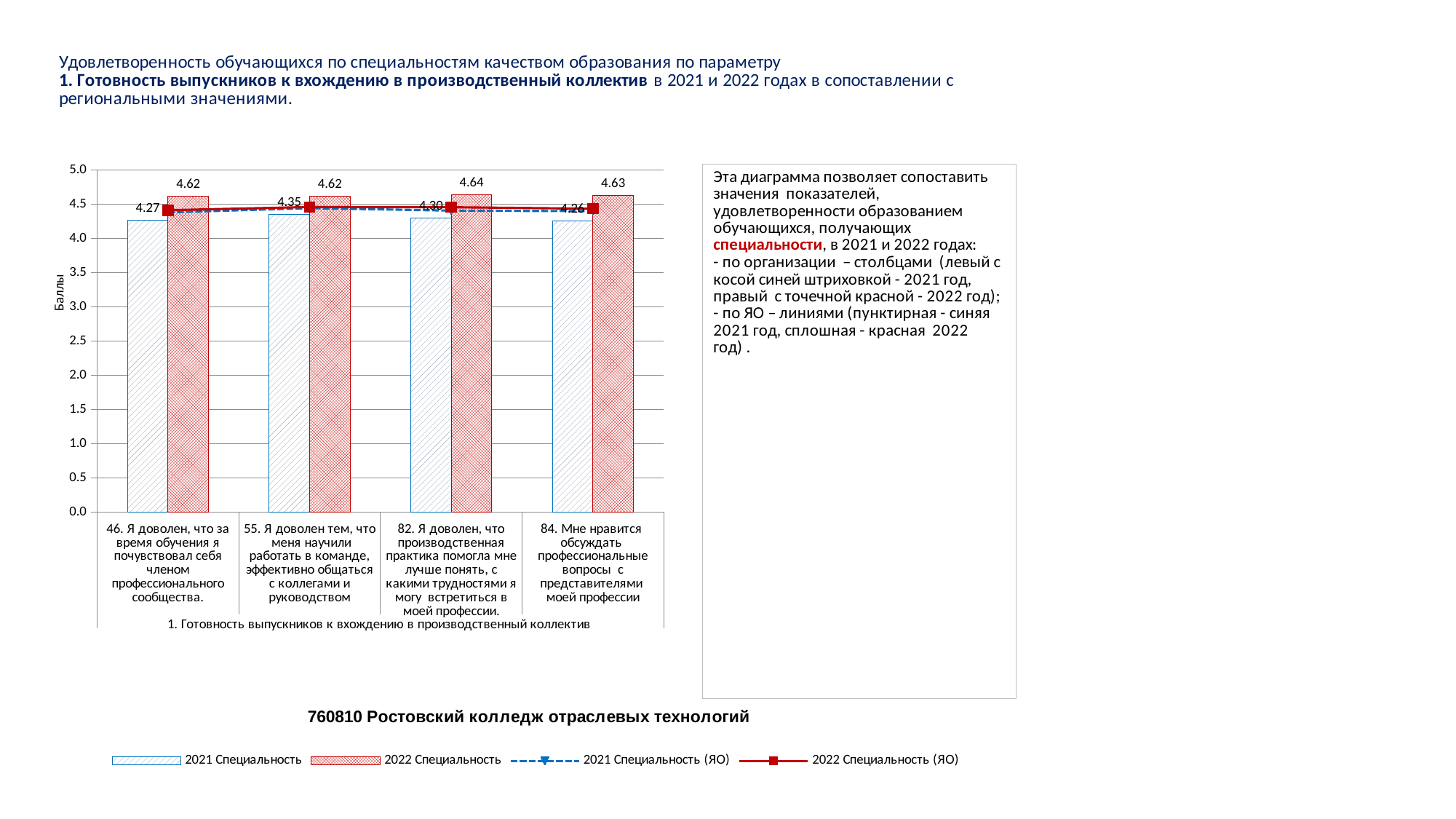
What is the value of the 2022 Специальность bar for category 82 (производственная практика помогла мне лучше понять)? 4.64 How many categories are shown on the x axis of the chart? 4 What is the value of the 2022 Специальность bar for category 46 (Я доволен, что за время обучения я почувствовал себя членом профессионального сообщества)? 4.62 Which category has the highest 2022 Специальность bar? 82. Я доволен, что производственная практика помогла мне лучше понять, с какими трудностями я могу встретиться в моей профессии. For category 84, which is larger: the 2021 Специальность bar or the 2022 Специальность bar? 2022 Специальность What is the title of the vertical axis of the chart? Баллы What is the difference between the 2022 and 2021 Специальность bars for category 55? 0.27 Which category has the highest 2021 Специальность bar? 55. Я доволен тем, что меня научили работать в команде, эффективно общаться с коллегами и руководством What is the value of the 2021 Специальность bar for category 55 (Я доволен тем, что меня научили работать в команде)? 4.35 What is the value of the 2021 Специальность bar for category 46? 4.27 Is the value of the 2022 Специальность (ЯО) line for category 46 greater or less than 4.0? greater How many series does the chart legend list? 4